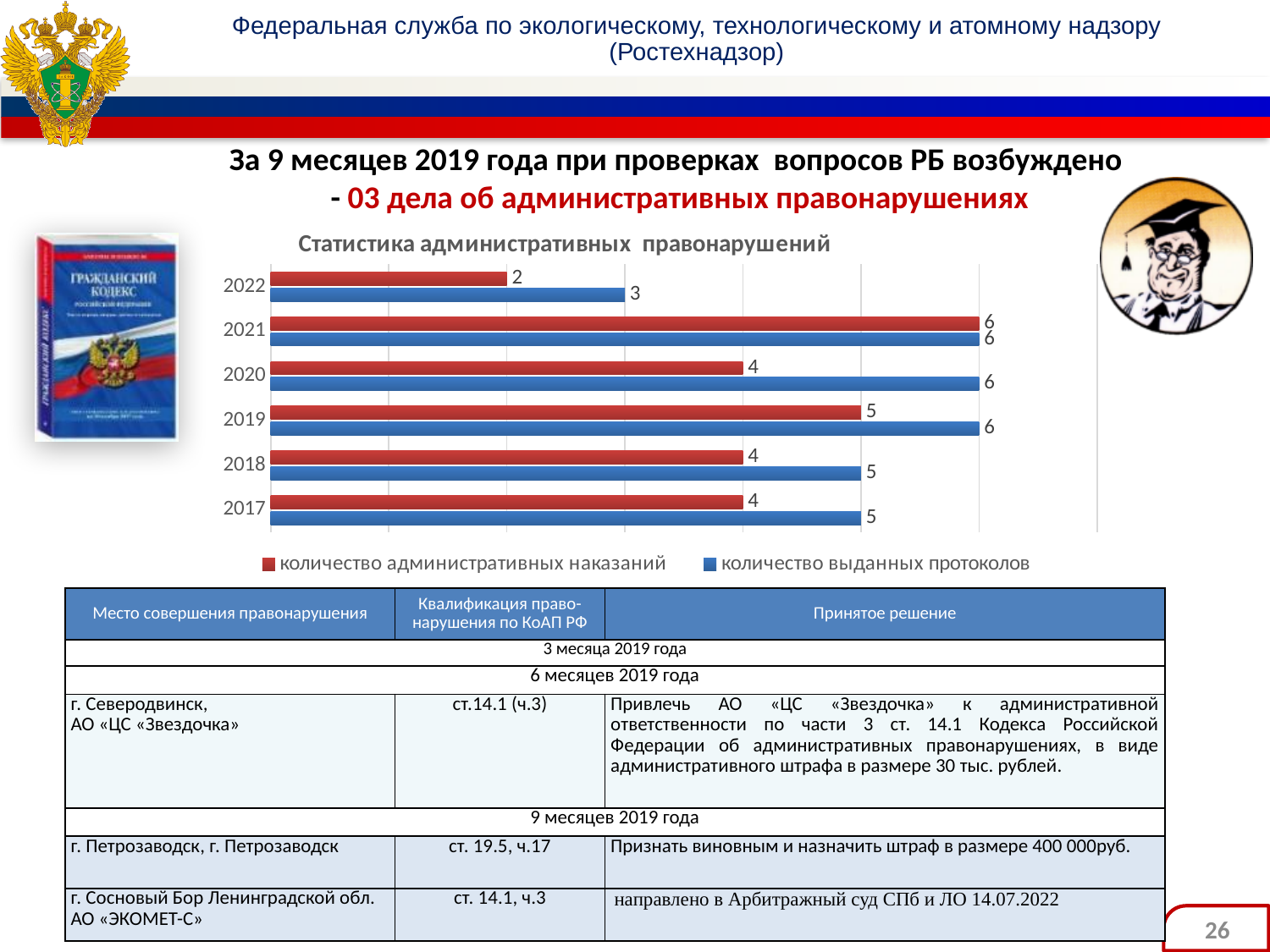
Which year has the lowest value of «количество административных наказаний»? 2022 Which series is shown in red on the chart? количество административных наказаний What is the value of «количество выданных протоколов» for 2017? 5 What is the value of «количество административных наказаний» for 2019? 5 In 2018, which is larger: «количество выданных протоколов» or «количество административных наказаний»? количество выданных протоколов How many years (categories) are shown on the chart? 6 What is the value of «количество выданных протоколов» for 2020? 6 What type of chart is shown under the title «Статистика административных правонарушений»? bar chart What is the value of «количество административных наказаний» for 2022? 2 How many series does the legend of the chart list? 2 Which year has the highest value of «количество административных наказаний»? 2021 What is the difference between «количество выданных протоколов» and «количество административных наказаний» in 2020? 2